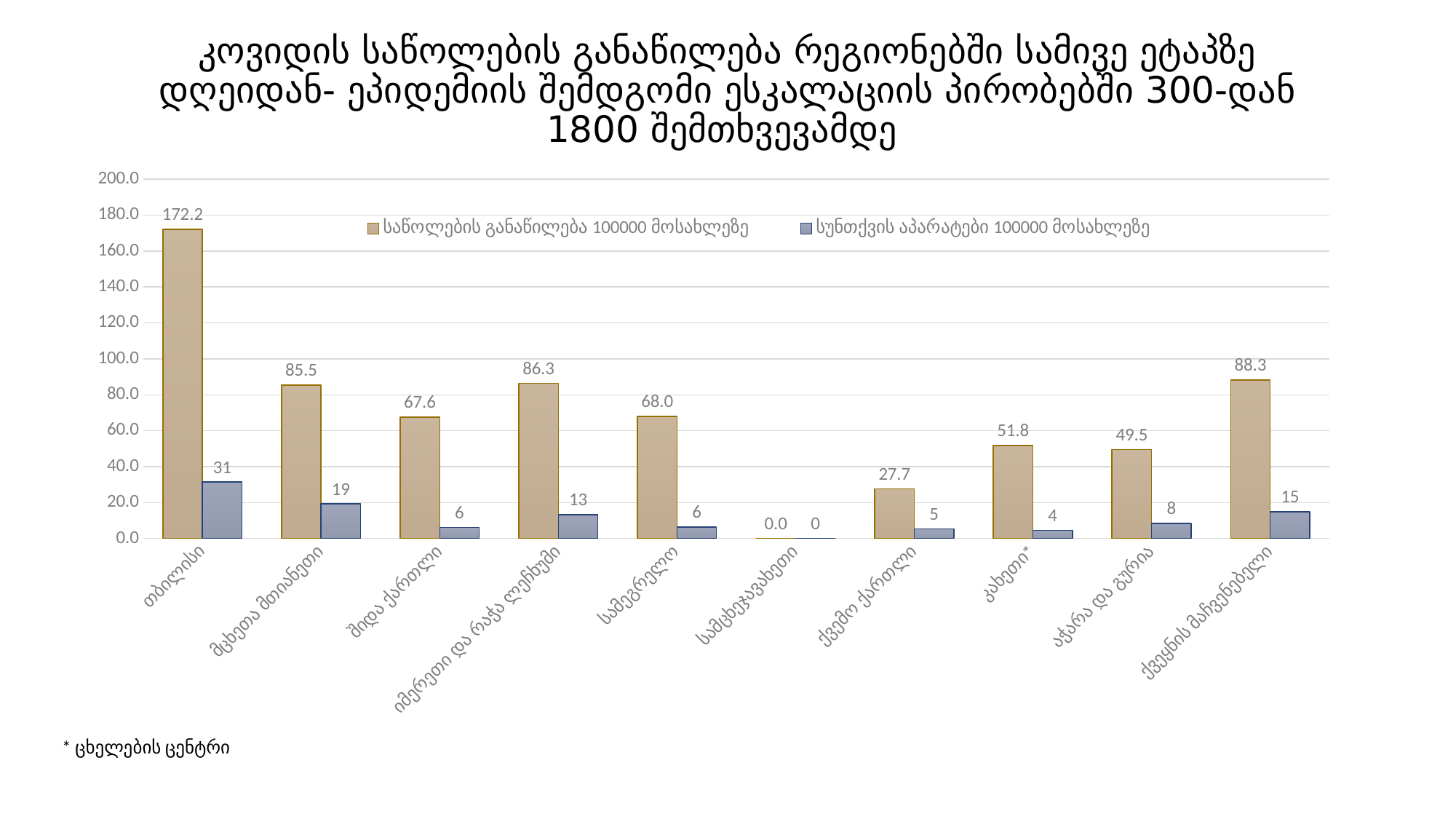
What is the value of საწოლების განაწილება 100000 მოსახლეზე for ქვეყნის მაჩვენებელი? 88.3 Which region has the highest value for საწოლების განაწილება 100000 მოსახლეზე? თბილისი What is the difference between the სუნთქვის აპარატები 100000 მოსახლეზე values for თბილისი and ქვეყნის მაჩვენებელი? 16 What is the value of საწოლების განაწილება 100000 მოსახლეზე for თბილისი? 172.2 Which has a larger value for საწოლების განაწილება 100000 მოსახლეზე: კახეთი* or ქვემო ქართლი? კახეთი* How many regions (categories) are shown on the x axis? 10 How many series does the legend list? 2 What does the footnote asterisk (*) on the slide refer to? ცხელების ცენტრი What is the difference between the საწოლების განაწილება 100000 მოსახლეზე values for თბილისი and ქვეყნის მაჩვენებელი? 83.9 What is the value of სუნთქვის აპარატები 100000 მოსახლეზე for მცხეთა მთიანეთი? 19 What type of chart is shown on the slide? bar chart Which region has the lowest value for სუნთქვის აპარატები 100000 მოსახლეზე? სამცხეჯავახეთი